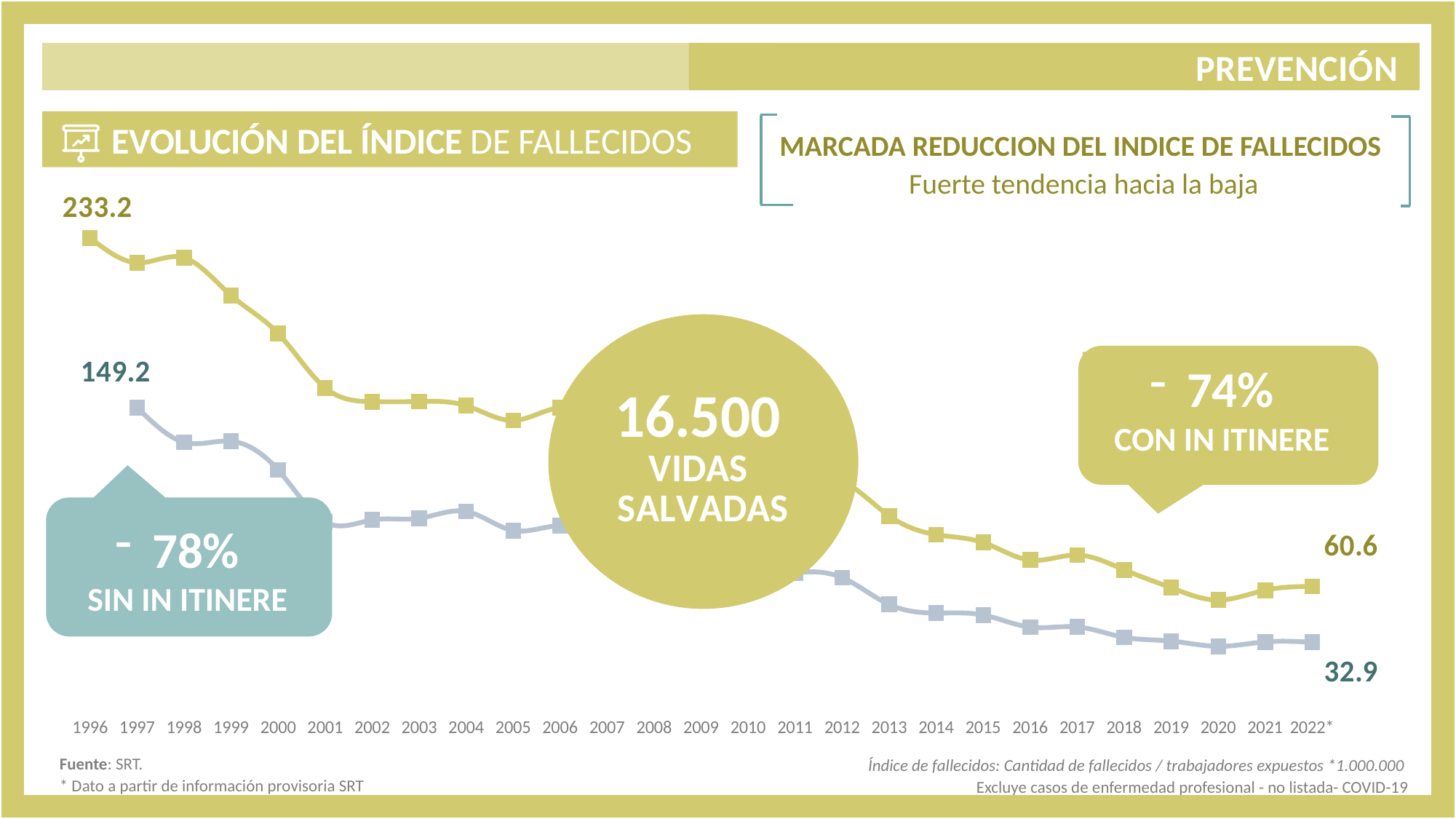
Which line has the larger value in 2022*, the yellow line or the grey line? The yellow line What is the difference between the two lines' values in 2022*? 27.7 In which year does the upper (yellow) line reach its highest value? 1996 How many years are shown on the x axis? 27 What is the value of the upper (yellow) line in 2022*? 60.6 What is the value of the lower (grey) line in 2022*? 32.9 Do the values of the lines rise or fall from 1996 to 2022*? Fall What type of chart is shown on the slide? Line chart What is the value of the upper (yellow) line in 1996? 233.2 By how much did the upper (yellow) line fall from 1996 to 2022*? 172.6